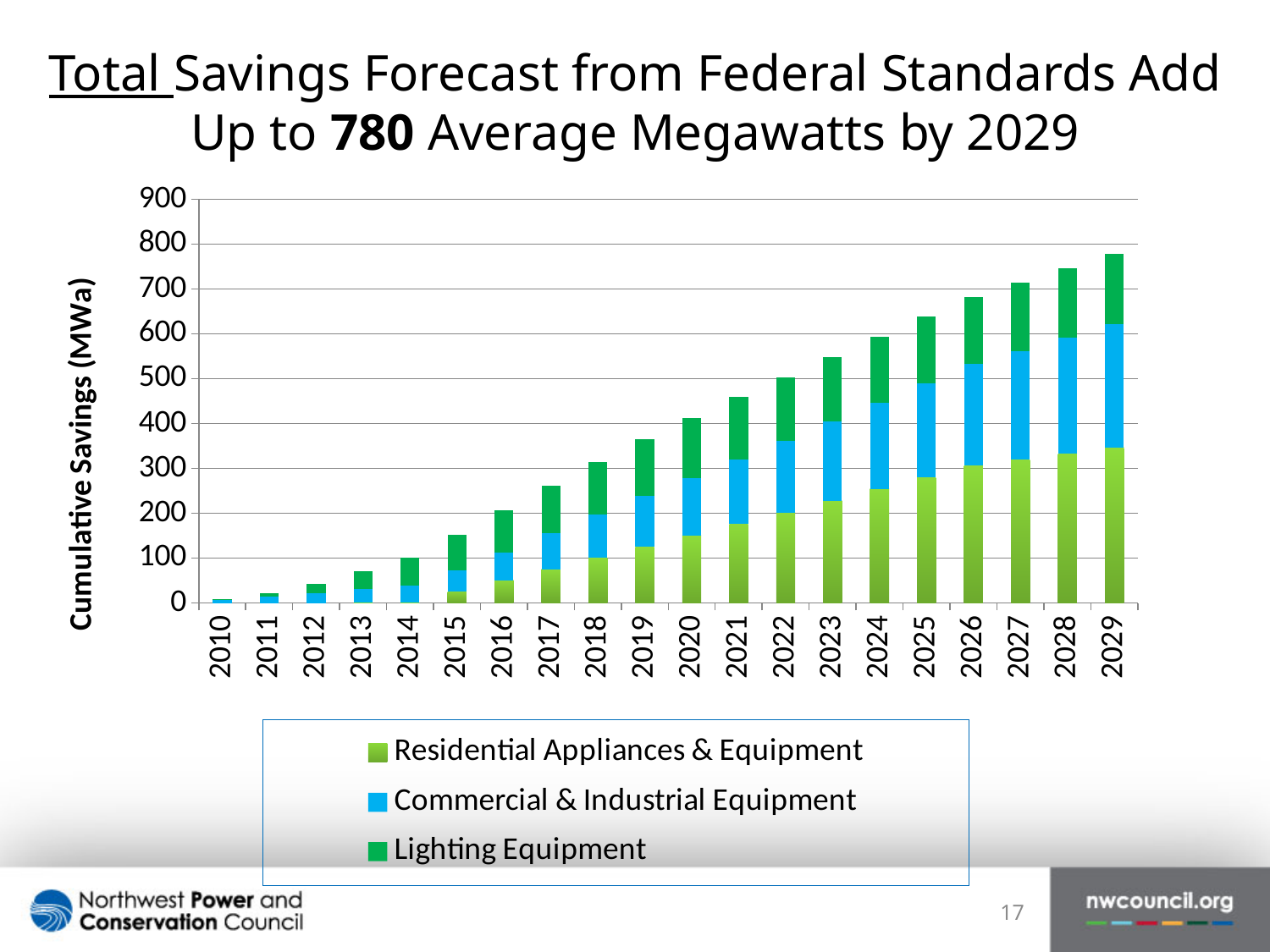
Which series is shown in the top (dark green) segment of each bar? Lighting Equipment Which year has the lowest total cumulative savings? 2010 Is the total cumulative savings for 2015 greater or less than 200? less Is the total cumulative savings for 2020 greater or less than 300? greater Is the total cumulative savings for 2029 greater or less than 700? greater Which year has a larger total cumulative savings, 2018 or 2025? 2025 What is the label on the y axis? Cumulative Savings (MWa) How many series does the legend list? 3 How many years are shown along the x axis? 20 Which year has the highest total cumulative savings? 2029 Do the total cumulative savings rise or fall from 2010 to 2029? Rise What kind of chart is shown on the slide? Stacked bar chart